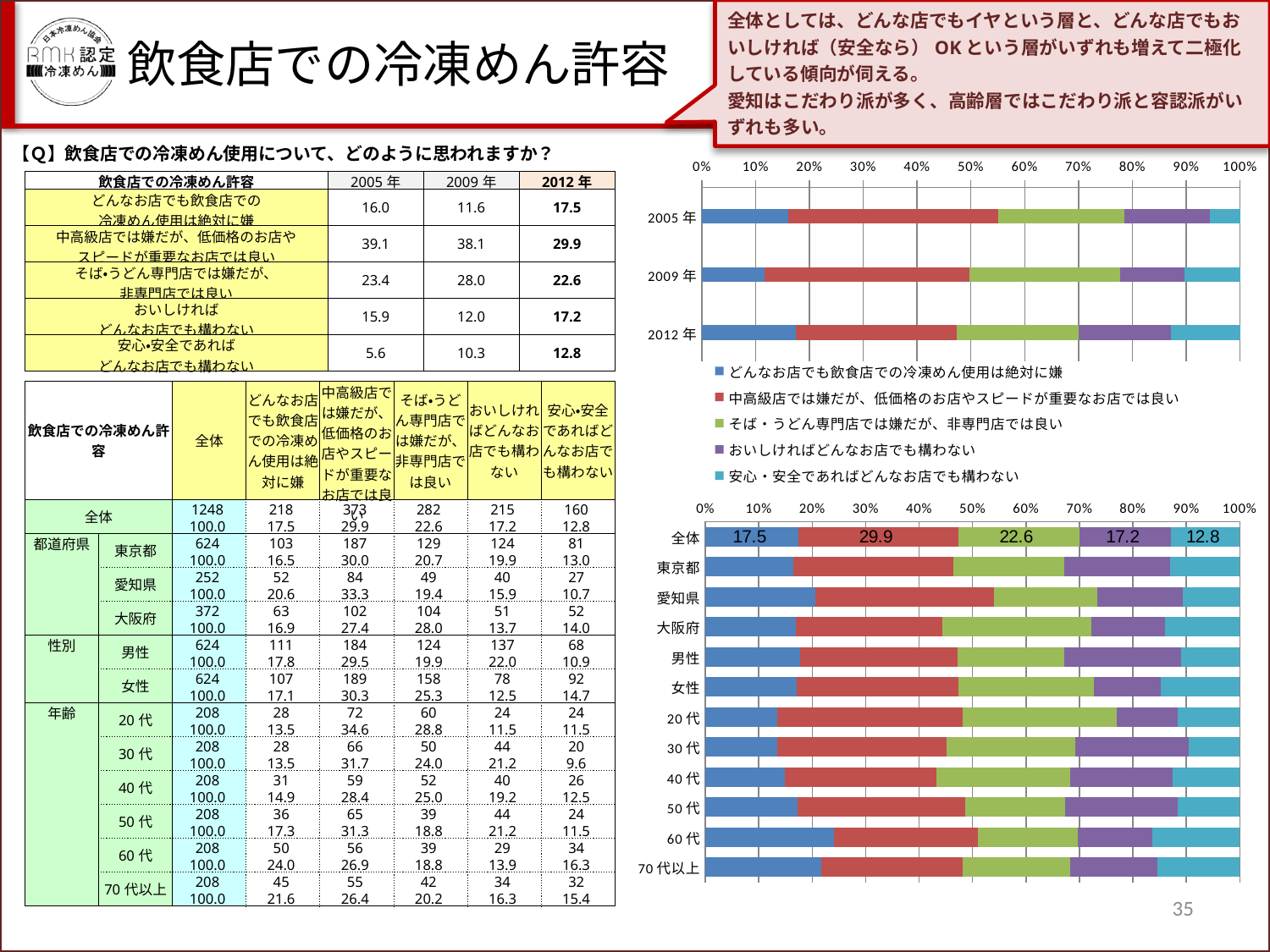
How many series does the legend list? 5 In the top chart, is the どんなお店でも飲食店での冷凍めん使用は絶対に嫌 segment for 2005年 greater or less than 20%? less In the bottom chart, what is the value for 全体 in the 安心・安全であればどんなお店でも構わない series? 12.8 In the bottom chart, which series has the largest segment in the 全体 bar? 中高級店では嫌だが、低価格のお店やスピードが重要なお店では良い How many categories are shown in the bottom chart? 12 In the bottom chart, which series has the smallest segment in the 全体 bar? 安心・安全であればどんなお店でも構わない In the bottom chart, for 全体, which is larger: the そば・うどん専門店では嫌だが、非専門店では良い segment or the おいしければどんなお店でも構わない segment? そば・うどん専門店では嫌だが、非専門店では良い How many categories are shown in the top chart? 3 In the bottom chart, what is the difference between the 全体 values for 中高級店では嫌だが… (29.9) and 安心・安全であれば… (12.8)? 17.1 In the bottom chart, what is the value for 全体 in the 中高級店では嫌だが、低価格のお店やスピードが重要なお店では良い series? 29.9 In the bottom chart, what is the total of the 全体 stacked bar? 100.0 What kind of chart is the top chart? Stacked bar chart